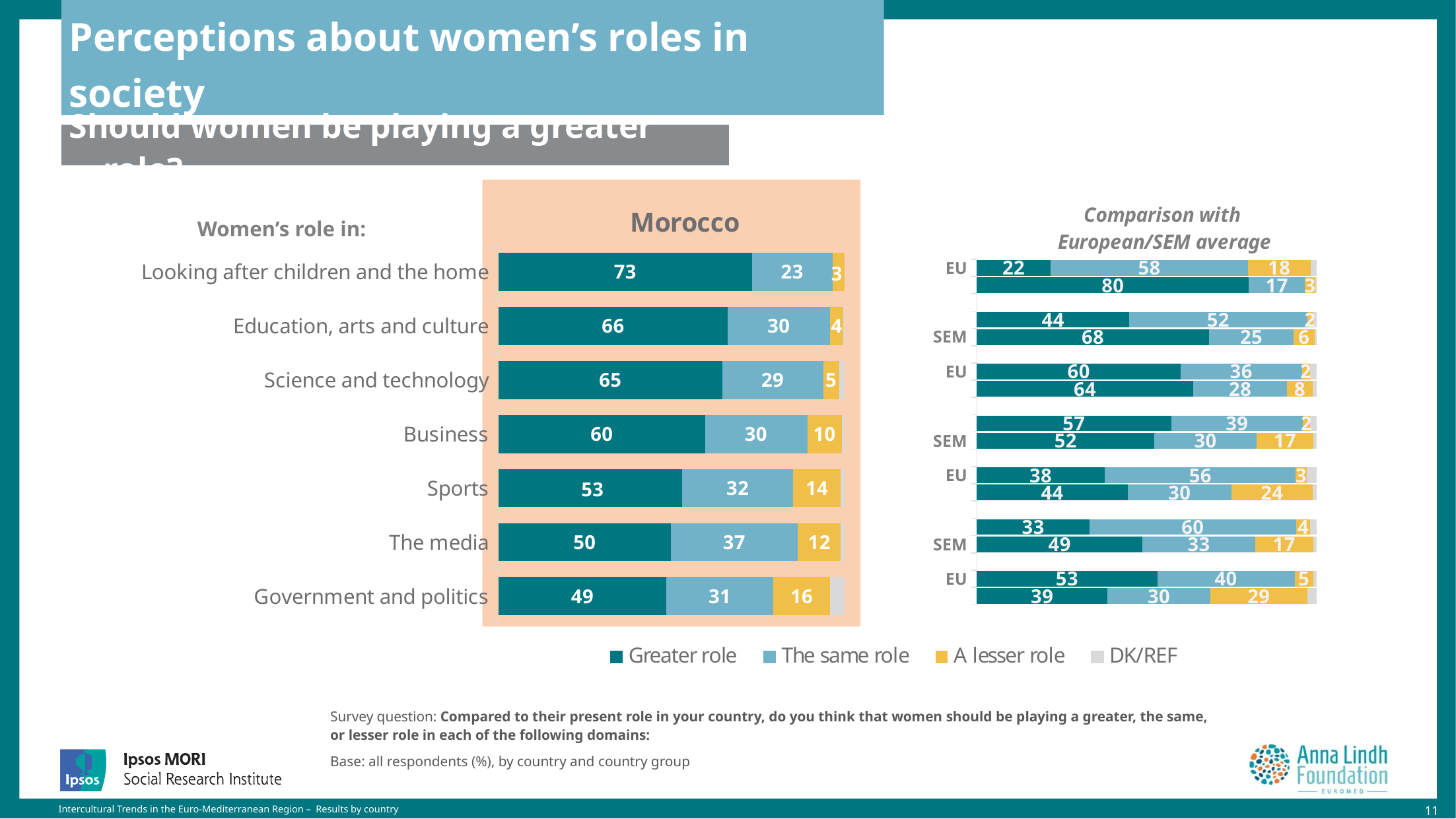
In the Morocco chart, what is the 'A lesser role' value for Government and politics? 16 How many domains are listed in the Morocco chart? 7 In the Morocco chart, what is the difference between the 'Greater role' values for Business and Sports? 7 What type of chart is the Morocco chart? Stacked bar chart In the Morocco chart, what is the 'The same role' value for The media? 37 In the Morocco chart, what percentage say women should play a greater role in looking after children and the home? 73 In the Morocco chart, which is larger: the 'Greater role' value for Education, arts and culture or for Science and technology? Education, arts and culture What is the title of the chart on the right of the slide? Comparison with European/SEM average In the Morocco chart, which domain has the highest 'Greater role' value? Looking after children and the home In the Morocco chart, which domain has the lowest 'A lesser role' value? Looking after children and the home In the Morocco chart, which domain has the lowest 'Greater role' value? Government and politics How many series does the legend list? 4